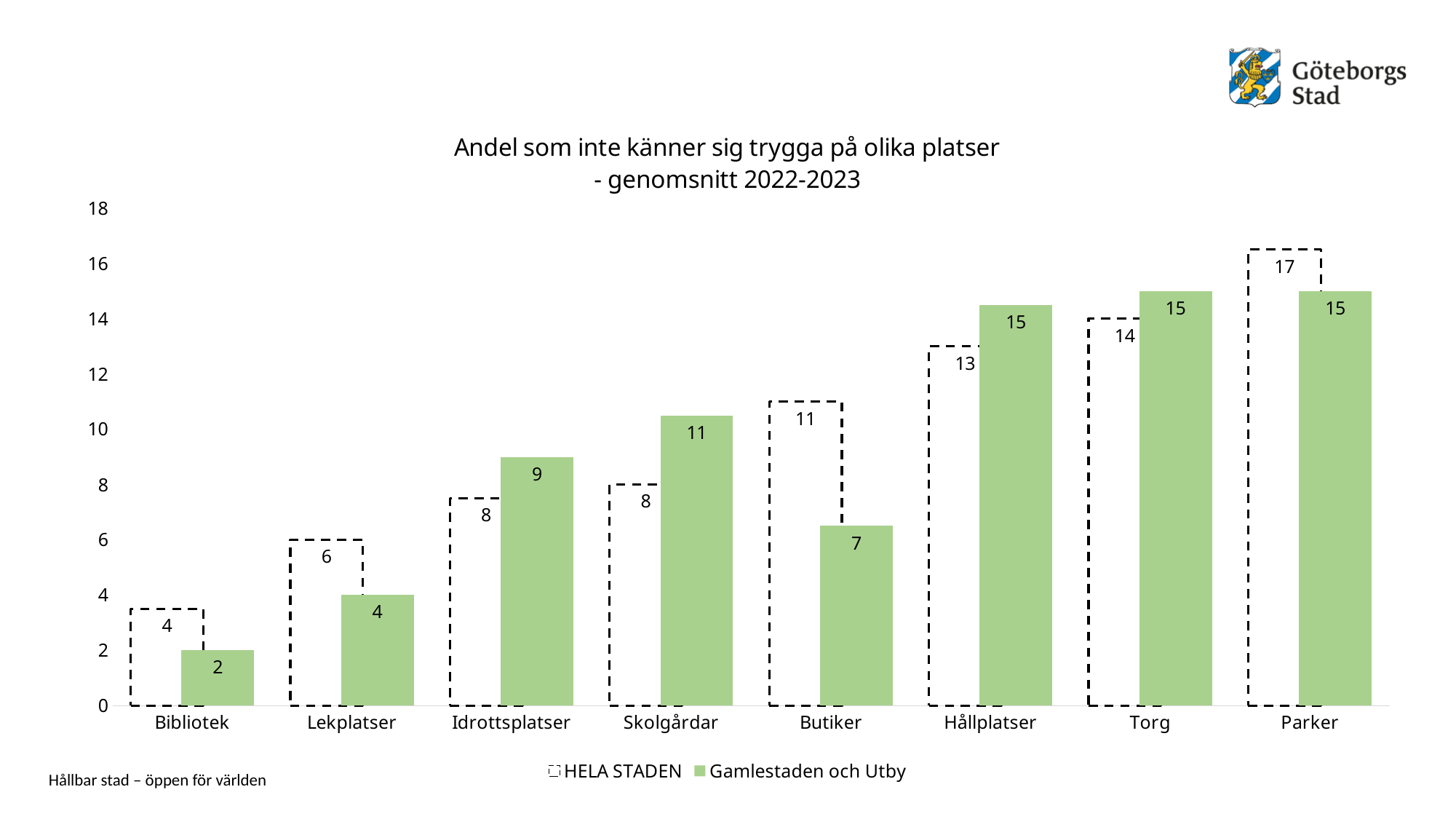
What is the value for HELA STADEN at Parker? 17 At Skolgårdar, which series has the larger value, HELA STADEN or Gamlestaden och Utby? Gamlestaden och Utby Do the HELA STADEN values rise or fall from Bibliotek to Parker? Rise Is the value for Gamlestaden och Utby at Hållplatser greater or less than 14? greater Which category has the lowest value for Gamlestaden och Utby? Bibliotek How many series does the legend list? 2 What is the difference between the HELA STADEN and Gamlestaden och Utby values at Butiker? 4 How many categories are shown on the x axis? 8 What is the value for Gamlestaden och Utby at Butiker? 7 What kind of chart is shown on the slide? Bar chart Which category has the highest value for HELA STADEN? Parker What is the value for Gamlestaden och Utby at Skolgårdar? 11